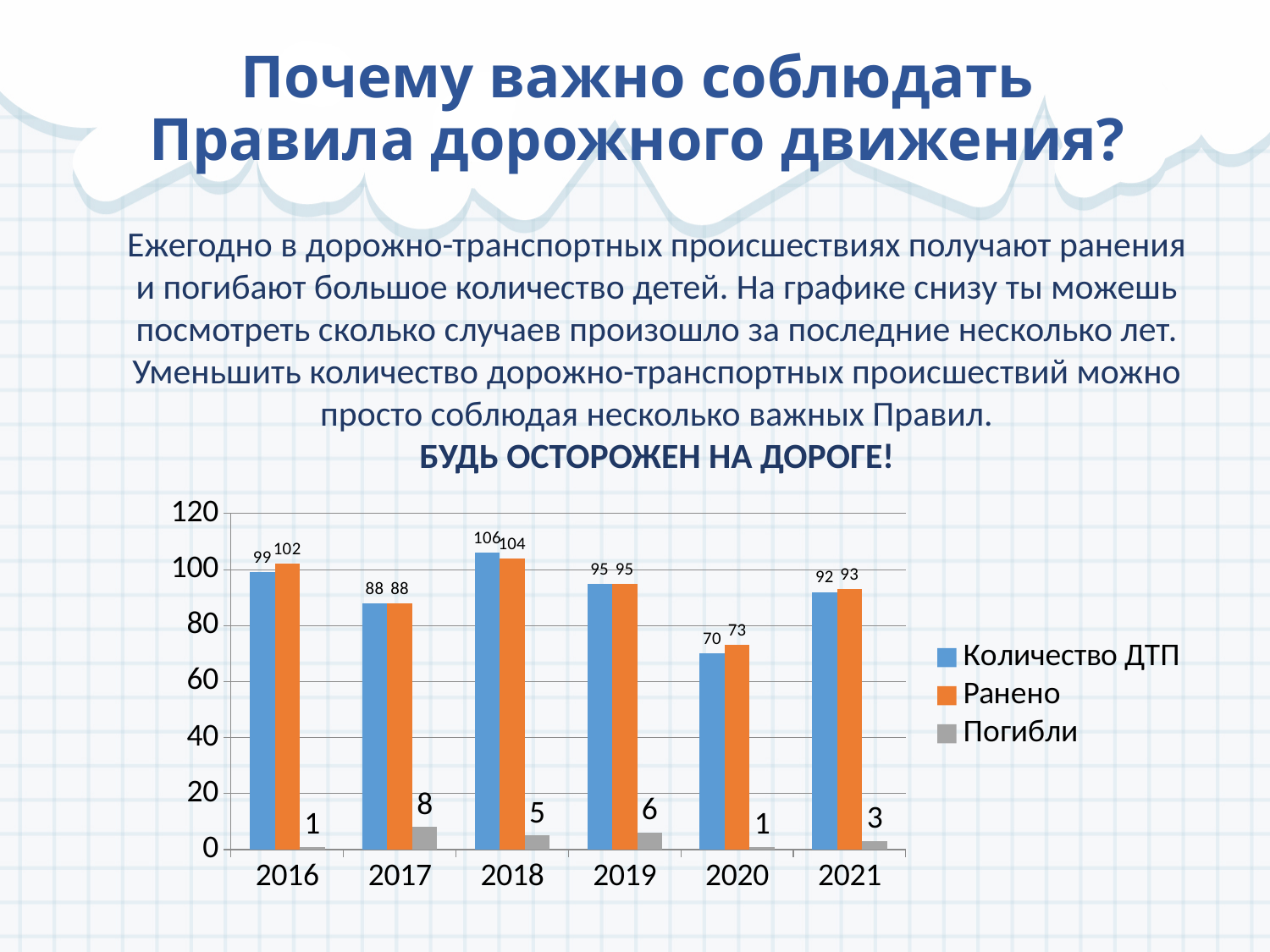
What kind of chart is shown on the slide? Bar chart What is the value of Ранено for 2020? 73 Which is larger in 2021: Количество ДТП or Ранено? Ранено Which year has the highest value for Количество ДТП? 2018 What is the value of Погибли for 2017? 8 How many years are shown on the x axis? 6 Which series is shown in orange in the legend? Ранено How many series does the legend list? 3 What is the value of Количество ДТП for 2018? 106 Which year has the lowest value for Ранено? 2020 Which year has the highest value for Погибли? 2017 What is the difference between Ранено and Количество ДТП in 2016? 3